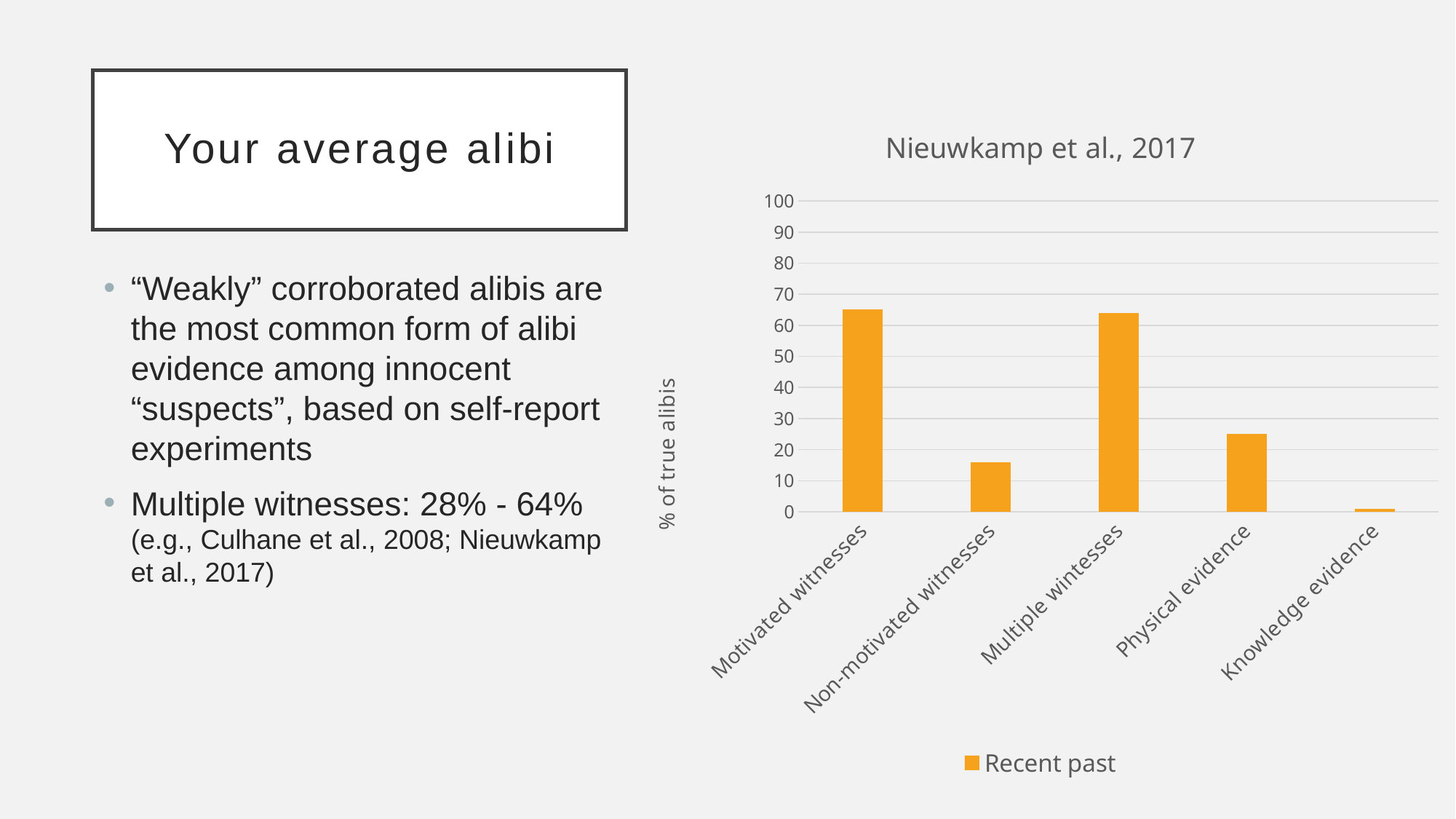
How many categories are shown on the x axis of the chart? 5 What is the title of the chart? Nieuwkamp et al., 2017 How many series does the chart's legend list? 1 Which category has the lowest value in the chart? Knowledge evidence Is the value for Multiple wintesses greater or less than 50? greater Is the value for Knowledge evidence greater or less than 10? less What kind of chart is shown on the slide? bar chart What is the label of the y axis of the chart? % of true alibis Is the value for Non-motivated witnesses greater or less than 20? less Which is larger, the value for Motivated witnesses or the value for Non-motivated witnesses? Motivated witnesses Which is larger, the value for Physical evidence or the value for Knowledge evidence? Physical evidence